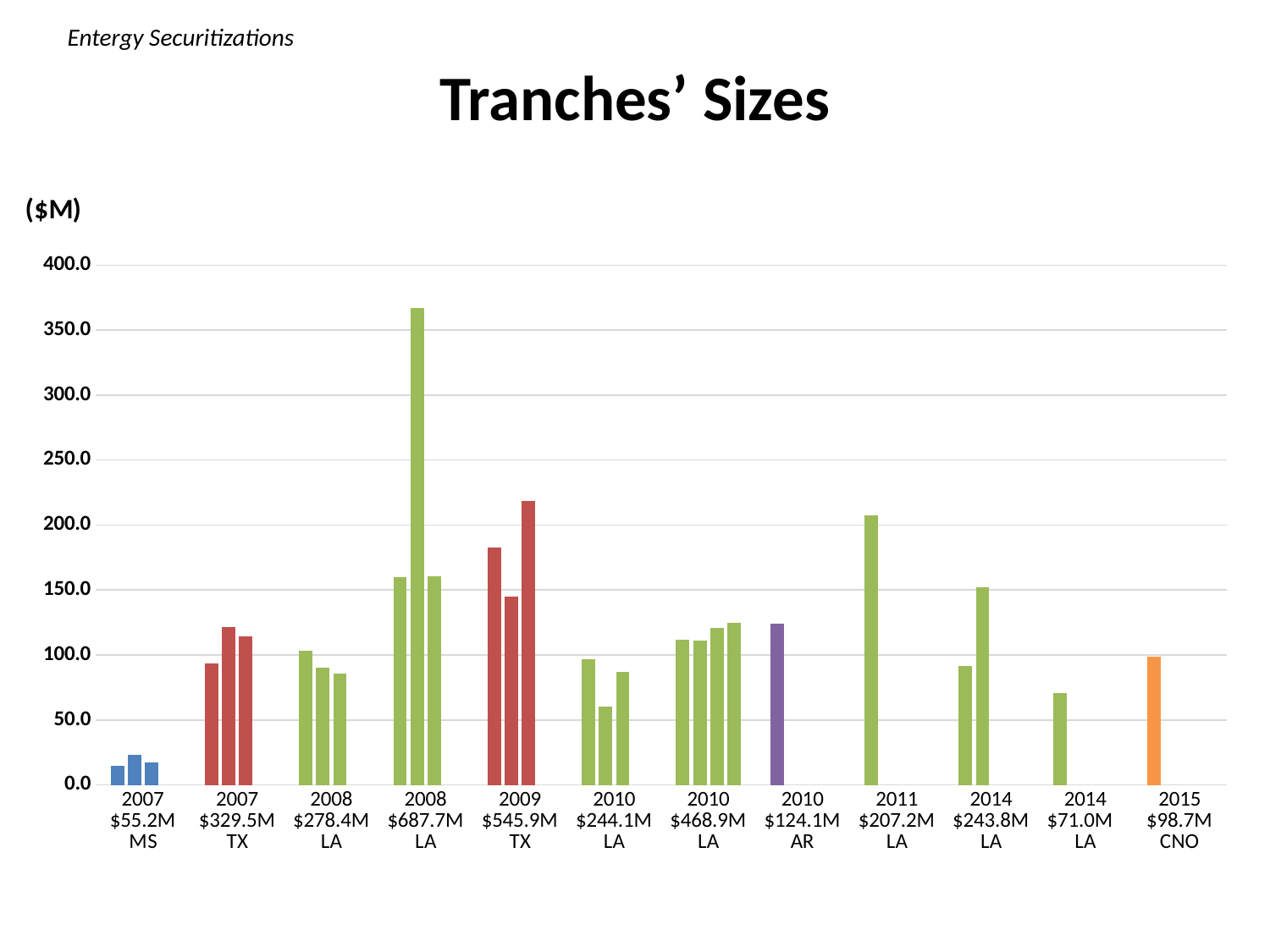
Which securitization has the smallest total size shown in its label? 2007 $55.2M MS Is the tallest bar in the 2008 $687.7M LA group greater or less than 350? greater What total size is shown for the 2011 LA securitization? $207.2M Which has the larger total: the 2009 TX securitization or the 2010 LA securitization labelled $468.9M? 2009 TX How many bars are in the 2010 LA group labelled $468.9M? 4 How many securitization groups are shown along the x axis? 12 What is the title of the chart? Tranches' Sizes Which securitization has the largest total size shown in its label? 2008 $687.7M LA What kind of chart is shown on the slide? bar chart What total size is shown for the 2010 AR securitization? $124.1M Is the single bar for the 2010 AR securitization greater or less than 150? less What is the difference between the 2007 TX total ($329.5M) and the 2008 LA total of $278.4M? $51.1M